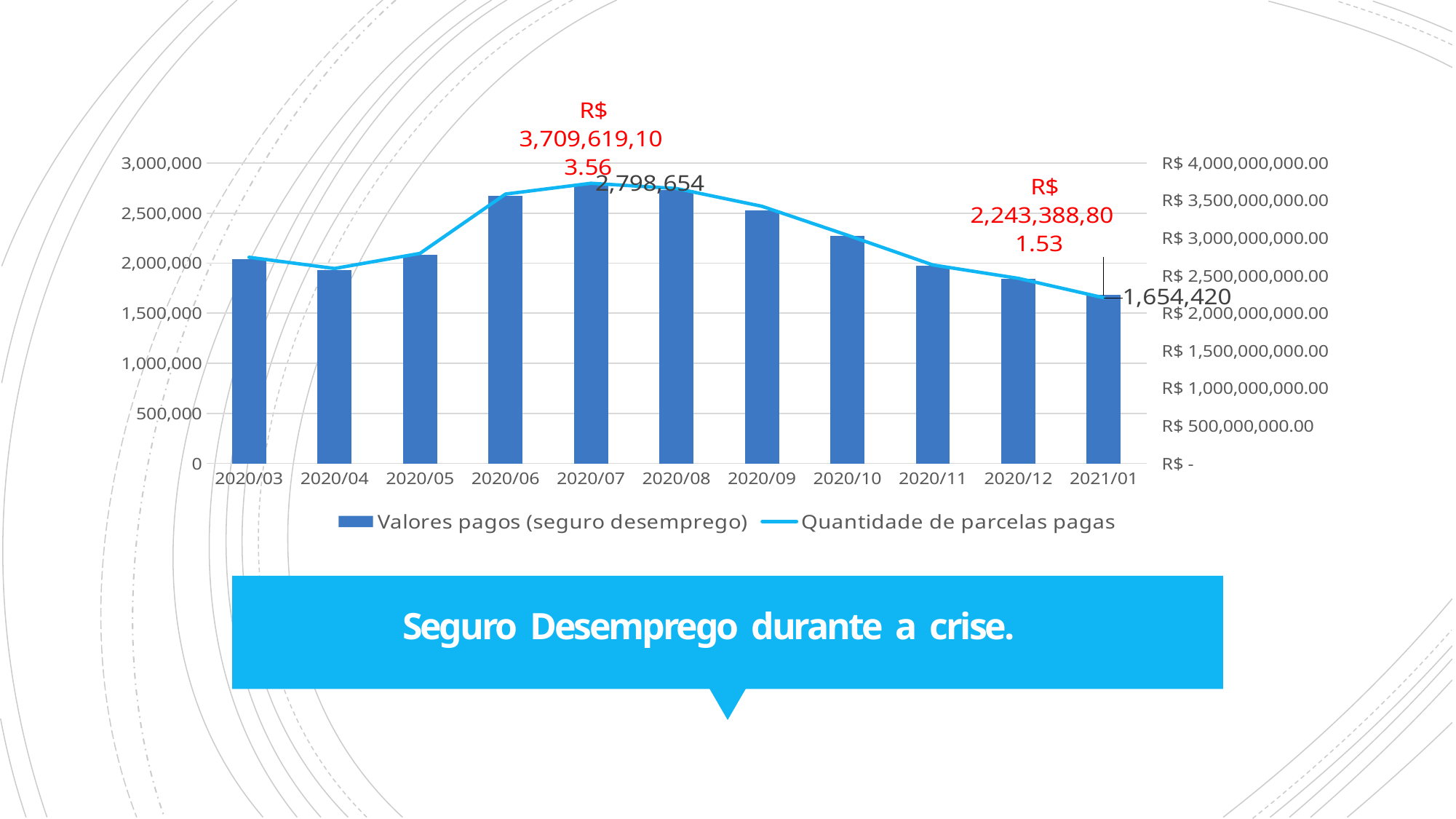
In which month is the Valores pagos (seguro desemprego) bar the lowest? 2021/01 Is the Valores pagos (seguro desemprego) bar for 2020/12 greater or less than 2,000,000 on the left axis? less What is the labelled value of Quantidade de parcelas pagas for 2020/07? 2,798,654 Which month has a larger Valores pagos (seguro desemprego) bar, 2020/06 or 2020/10? 2020/06 What is the labelled value of Valores pagos (seguro desemprego) for 2020/07? R$ 3,709,619,103.56 How many months are shown along the x axis? 11 In which month is the Valores pagos (seguro desemprego) bar the highest? 2020/07 What is the labelled value of Quantidade de parcelas pagas for 2021/01? 1,654,420 What is the labelled value of Valores pagos (seguro desemprego) for 2021/01? R$ 2,243,388,801.53 What kind of chart is shown on the slide? A combination bar and line chart What is the difference between the Quantidade de parcelas pagas values labelled for 2020/07 and 2021/01? 1,144,234 How many series does the legend list? 2